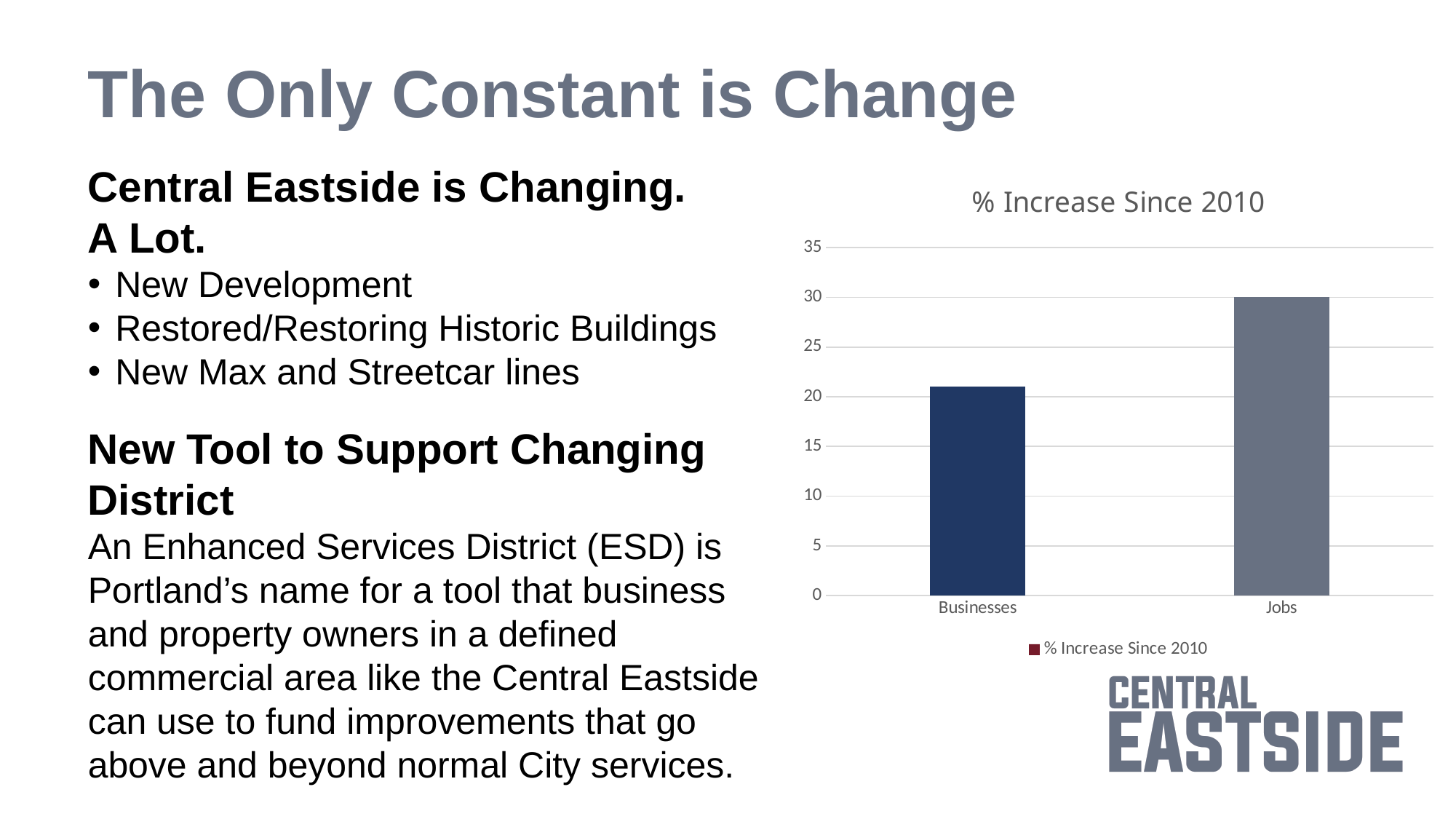
What is the title of the chart? % Increase Since 2010 Which is larger, the value for Businesses or the value for Jobs? Jobs How many series does the chart legend list? 1 Is the value for Businesses greater or less than 15? greater Is the value for Jobs greater or less than 35? less Is the value for Jobs greater or less than 25? greater Which category has the lowest value in the chart? Businesses How many categories are plotted in the chart? 2 What kind of chart is shown on the slide? bar chart Which category has the highest value in the chart? Jobs What is the name of the series shown in the chart legend? % Increase Since 2010